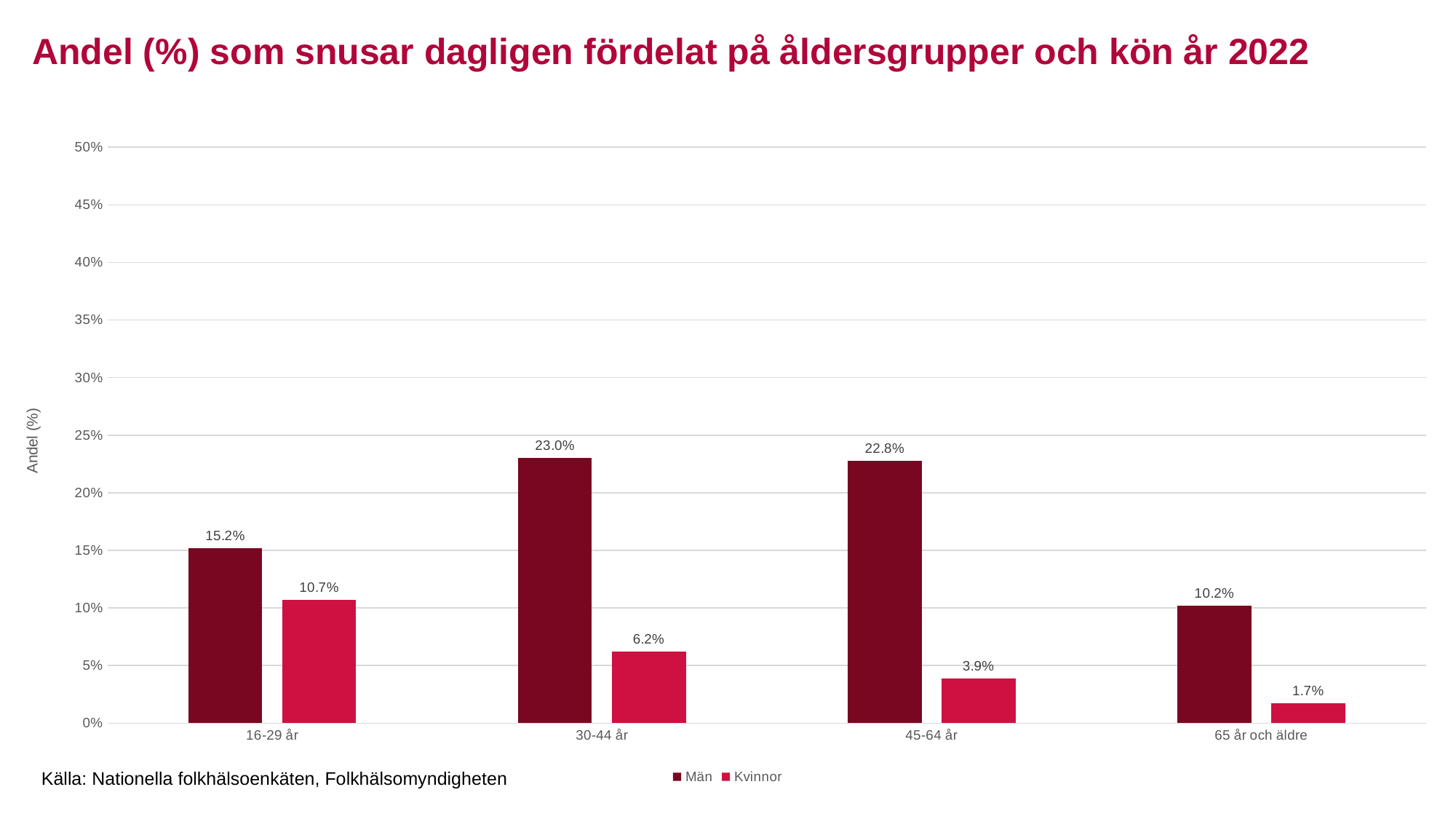
What is the value for Män in the 30-44 år age group? 23.0% Which age group has the lowest value for Män? 65 år och äldre How many age groups are shown on the x axis? 4 What is the value for Kvinnor in the 65 år och äldre age group? 1.7% Which is larger: the Män value for 16-29 år or the Män value for 65 år och äldre? 16-29 år Is the value for Män in the 45-64 år age group greater or less than 20%? greater What kind of chart is shown on the slide? bar chart How many series does the legend list? 2 What is the value for Kvinnor in the 16-29 år age group? 10.7% Do the Kvinnor values rise or fall from the youngest to the oldest age group? fall What is the difference between the Män and Kvinnor values in the 45-64 år age group? 18.9% Which age group has the highest value for Kvinnor? 16-29 år